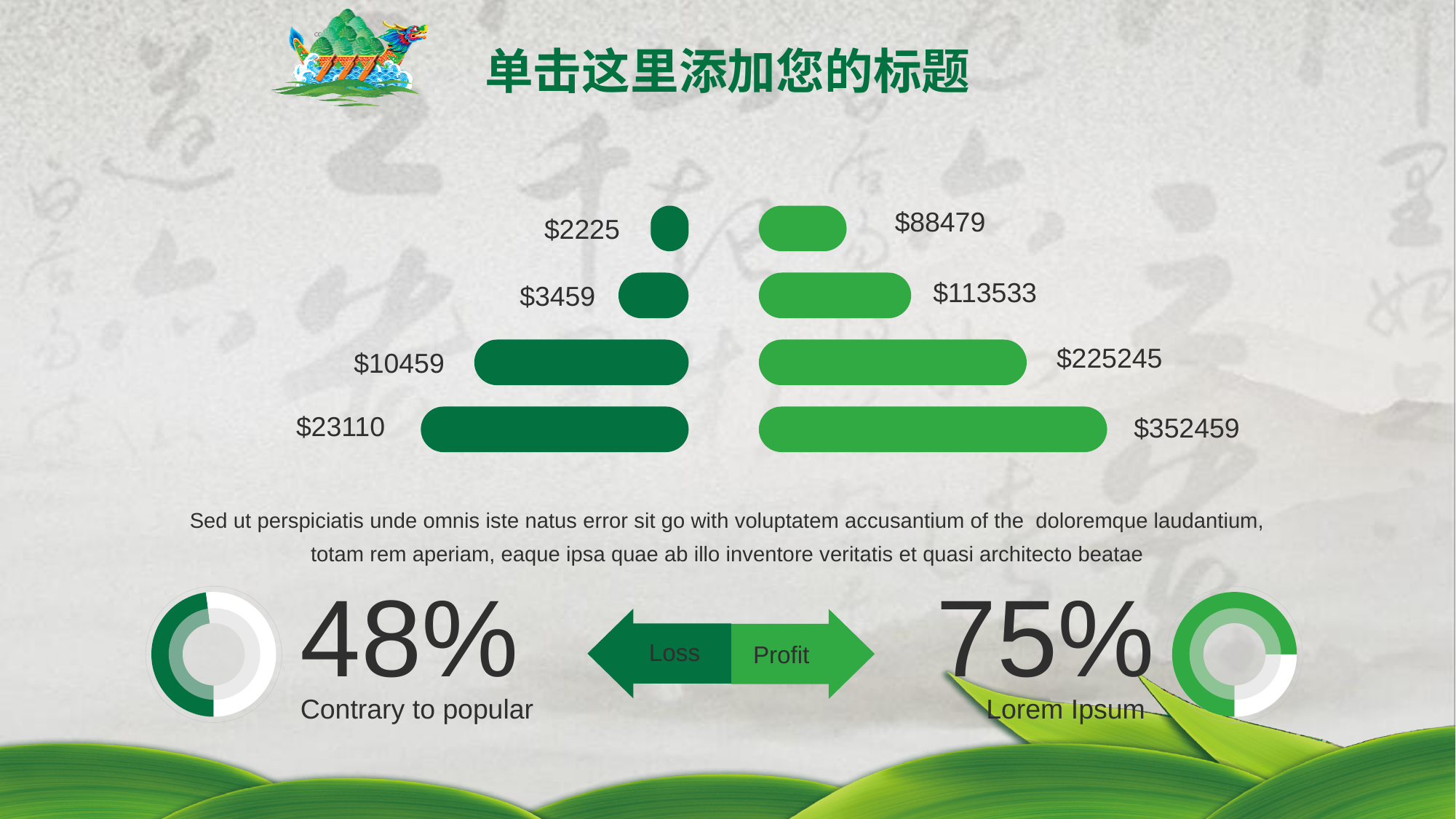
What is the Loss value on the third row from the top of the bar chart? $10459 What is the Profit value on the bottom row of the bar chart? $352459 What percentage is shown next to the left circular gauge labelled 'Contrary to popular'? 48% What is the Profit value on the second row from the top of the bar chart? $113533 How many rows of bars does the bar chart have? 4 What is the difference between the largest and smallest Loss values in the bar chart? $20885 What is the Loss value on the top row of the bar chart? $2225 What is the largest Loss value shown in the bar chart? $23110 What is the difference between the Profit values on the bottom row and the top row of the bar chart? $263980 What is the smallest Profit value shown in the bar chart? $88479 What kind of chart is used to show the Loss and Profit values? Bar chart Which is larger on the bottom row of the bar chart, the Loss value or the Profit value? Profit